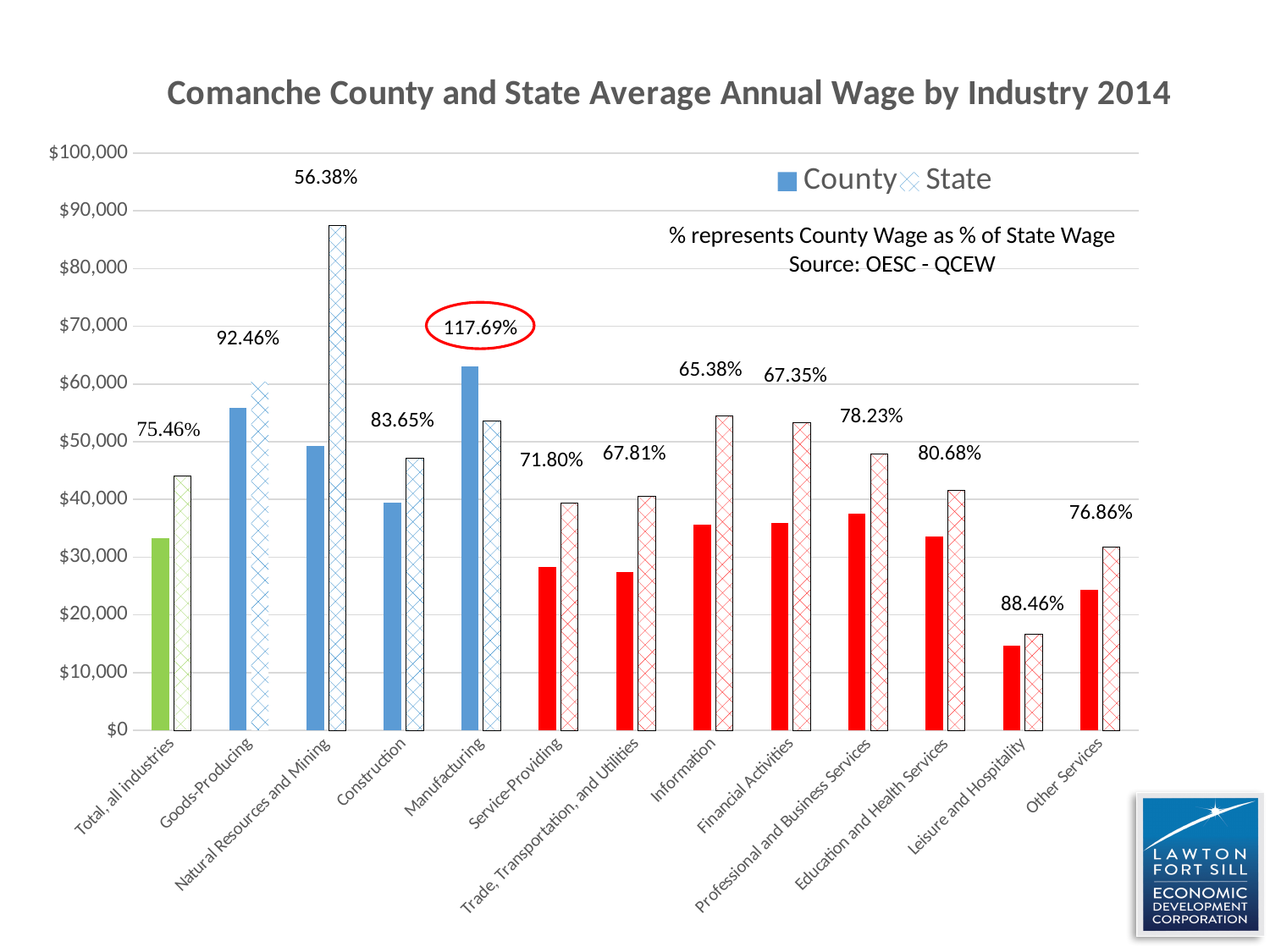
Is the County wage for Leisure and Hospitality greater or less than $20,000? less How many series does the legend list? 2 For Manufacturing, which is larger, the County wage or the State wage? County Which industry has the lowest County wage as a percentage of State wage? Natural Resources and Mining Is the State wage for Natural Resources and Mining greater or less than $80,000? greater What percentage label is shown for Natural Resources and Mining? 56.38% What percentage label is shown for Manufacturing? 117.69% What is the difference in percentage points between the Manufacturing label (117.69%) and the Construction label (83.65%)? 34.04 What kind of chart is shown on the slide? Bar chart What percentage label is shown for Leisure and Hospitality? 88.46% Which industry has the highest County wage as a percentage of State wage? Manufacturing How many industry categories are shown on the x axis? 13